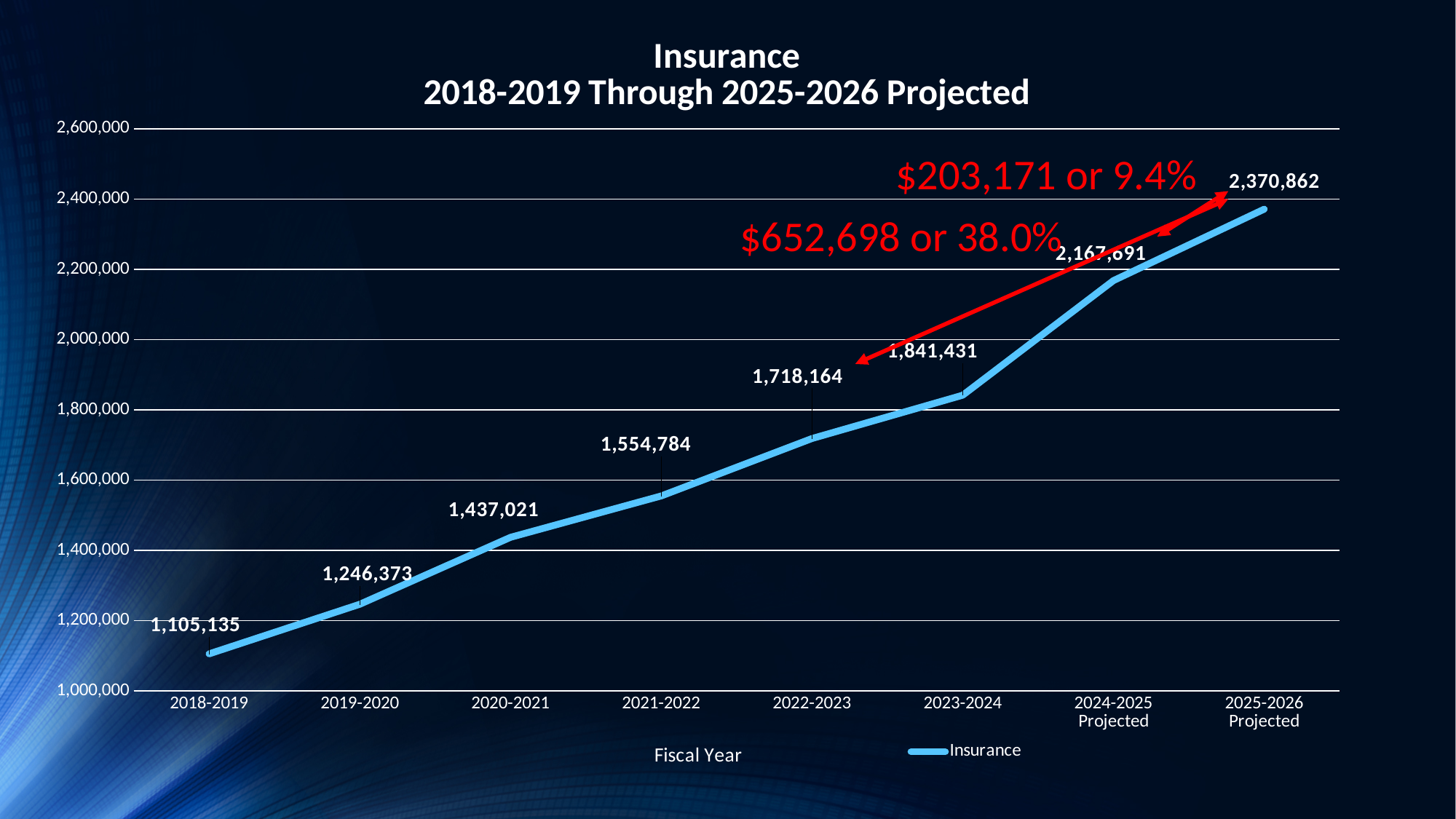
What is the difference between the Insurance values for 2023-2024 and 2022-2023? 123,267 How many fiscal years are plotted on the chart? 8 Is the Insurance value for 2024-2025 Projected greater or less than 2,000,000? greater What is the difference between the Insurance values for 2019-2020 and 2018-2019? 141,238 What is the Insurance value for 2018-2019? 1,105,135 What is the projected Insurance value for 2025-2026? 2,370,862 What type of chart is shown on the slide? Line chart What is the Insurance value for 2020-2021? 1,437,021 Which fiscal year has the lowest Insurance value? 2018-2019 Which fiscal year has the highest Insurance value? 2025-2026 Projected What is the Insurance value for 2022-2023? 1,718,164 Do the Insurance values rise or fall from 2018-2019 to 2025-2026 Projected? Rise